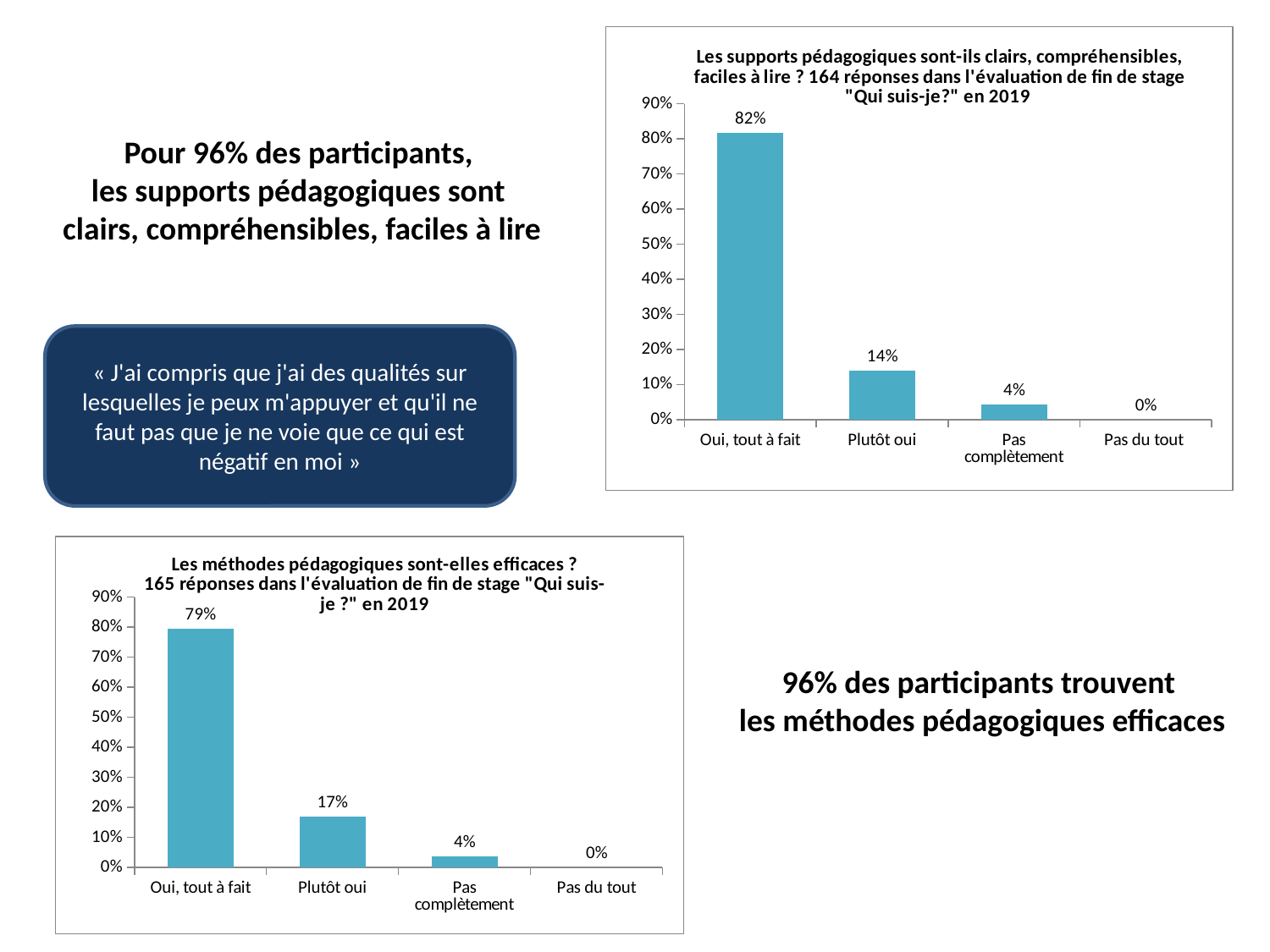
In the bottom-left chart about whether the teaching methods are effective, which category has the lowest value? Pas du tout In the top-right chart about whether the teaching materials are clear, do the values rise or fall from left to right along the x axis? Fall In the top-right chart about whether the teaching materials are clear, what is the difference between "Oui, tout à fait" and "Plutôt oui"? 68% In the top-right chart about whether the teaching materials are clear, which category has the highest value? Oui, tout à fait In the bottom-left chart about whether the teaching methods are effective, what is the value for "Plutôt oui"? 17% In the top-right chart about whether the teaching materials are clear, what is the value for "Plutôt oui"? 14% What kind of chart is the top-right chart about whether the teaching materials are clear? Bar chart In the bottom-left chart about whether the teaching methods are effective, what is the difference between "Plutôt oui" and "Pas complètement"? 13% In the bottom-left chart about whether the teaching methods are effective, what is the value for "Oui, tout à fait"? 79% How many categories are shown on the x axis of the bottom-left chart about whether the teaching methods are effective? 4 Which is larger: "Plutôt oui" in the top-right chart or "Plutôt oui" in the bottom-left chart? Bottom-left chart (17%) In the top-right chart about whether the teaching materials are clear, what is the value for "Oui, tout à fait"? 82%